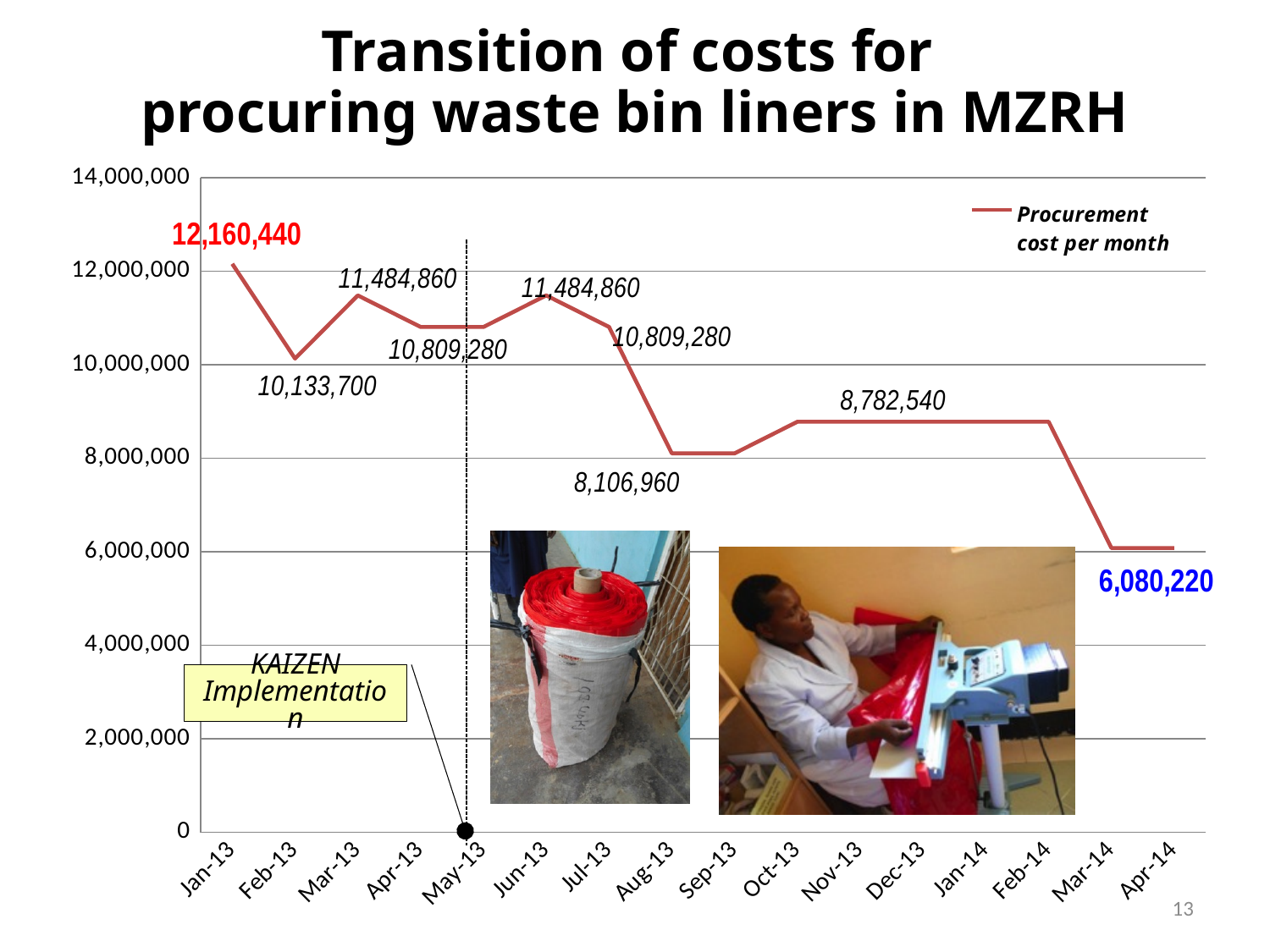
How many months are shown on the x axis? 16 What is the procurement cost per month for Feb-13? 10,133,700 What is the procurement cost per month for Apr-14? 6,080,220 What is the difference between the procurement cost in Jan-13 and in Apr-14? 6,080,220 What type of chart is shown on the slide? Line chart Which month has a higher procurement cost, Jan-13 or Feb-13? Jan-13 What is the lowest procurement cost value shown on the chart? 6,080,220 Does the procurement cost overall rise or fall from Jan-13 to Apr-14? Fall What is the procurement cost per month for Aug-13? 8,106,960 Is the procurement cost for Nov-13 greater or less than 10,000,000? less Which month has the highest procurement cost? Jan-13 What is the procurement cost per month for Jan-13? 12,160,440